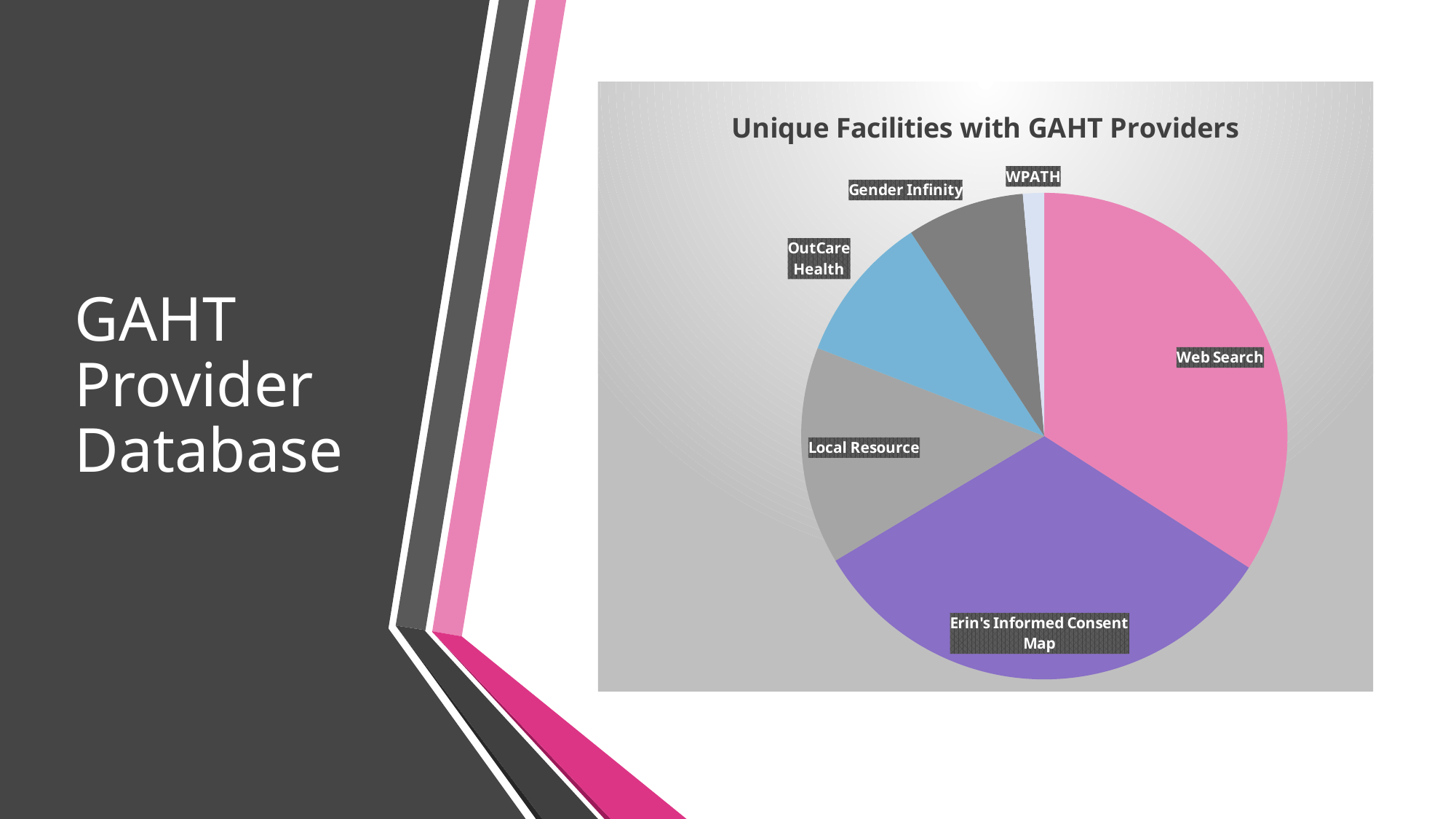
Which category has the largest slice of the pie? Web Search Which slice is larger, Web Search or OutCare Health? Web Search What is the title of the chart? Unique Facilities with GAHT Providers Which category is shown in the pink slice? Web Search Which slice is larger, Erin's Informed Consent Map or Local Resource? Erin's Informed Consent Map Which category has the smallest slice of the pie? WPATH Which slice is larger, Gender Infinity or WPATH? Gender Infinity How many slices does the pie chart have? 6 What kind of chart is shown on the slide? pie chart